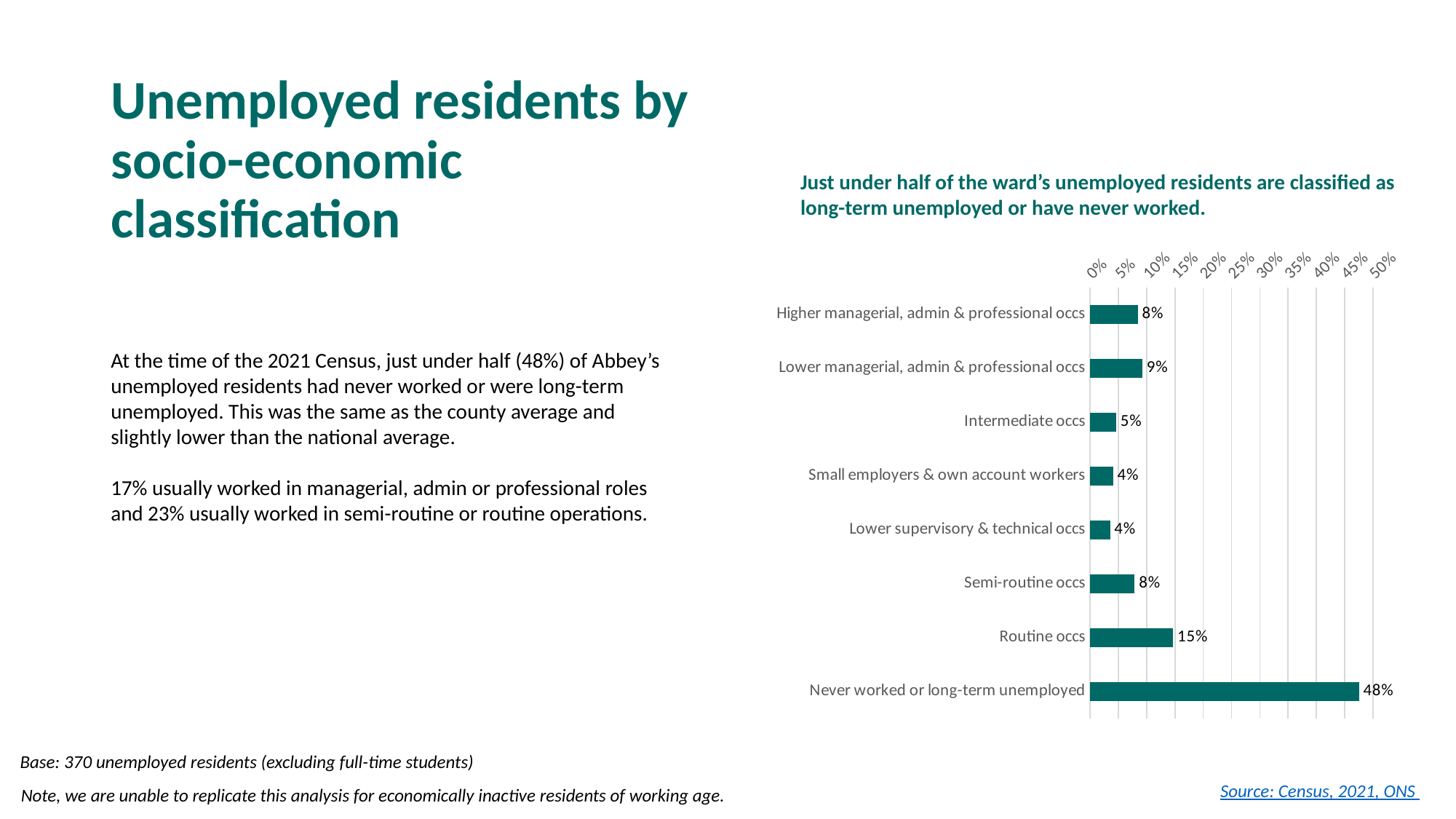
What kind of chart is shown on the slide? Bar chart What is the difference between the values for 'Never worked or long-term unemployed' and 'Routine occs'? 33% Which category has the highest value in the chart? Never worked or long-term unemployed What is the value shown for 'Lower managerial, admin & professional occs'? 9% What is the difference between the values for 'Lower managerial, admin & professional occs' and 'Intermediate occs'? 4% What is the highest value shown on the chart's percentage axis? 50% Which is larger: the value for 'Routine occs' or the value for 'Semi-routine occs'? Routine occs What is the value shown for 'Intermediate occs'? 5% What percentage of unemployed residents are classified as 'Never worked or long-term unemployed'? 48% What is the value shown for 'Routine occs'? 15% Is the value for 'Never worked or long-term unemployed' greater or less than 40%? greater How many categories are shown in the chart? 8